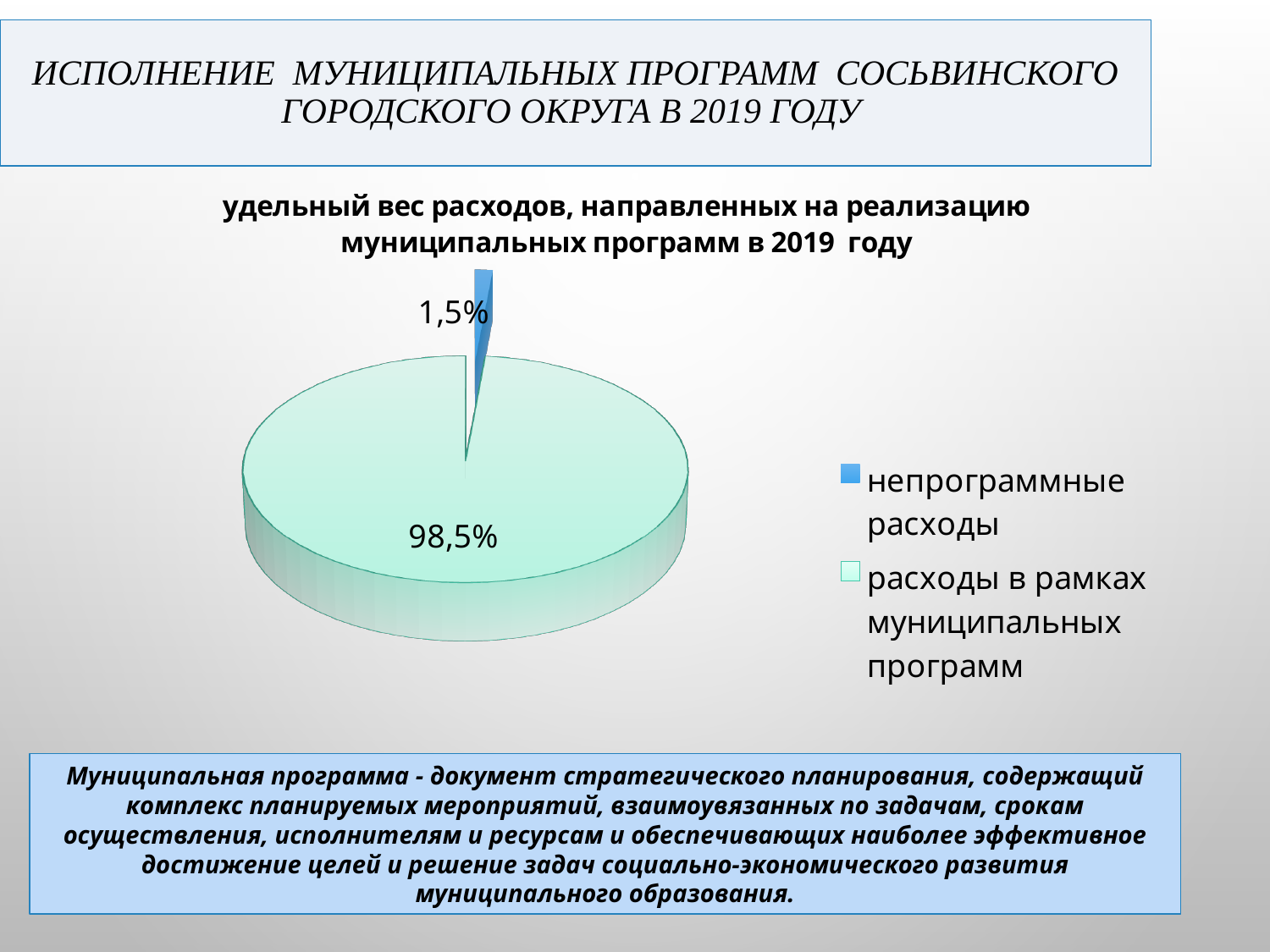
What is the difference in percentage points between расходы в рамках муниципальных программ and непрограммные расходы? 97 percentage points What kind of chart is shown on the slide? pie chart What colour is the slice for непрограммные расходы? blue Which category has the largest slice of the pie? расходы в рамках муниципальных программ How many entries does the legend list? 2 What share of the pie is labelled for непрограммные расходы? 1,5% What is the title of the chart? удельный вес расходов, направленных на реализацию муниципальных программ в 2019 году What share of the pie is labelled for расходы в рамках муниципальных программ? 98,5% How many slices does the pie chart have? 2 Which is larger: непрограммные расходы or расходы в рамках муниципальных программ? расходы в рамках муниципальных программ Which category has the smallest slice of the pie? непрограммные расходы